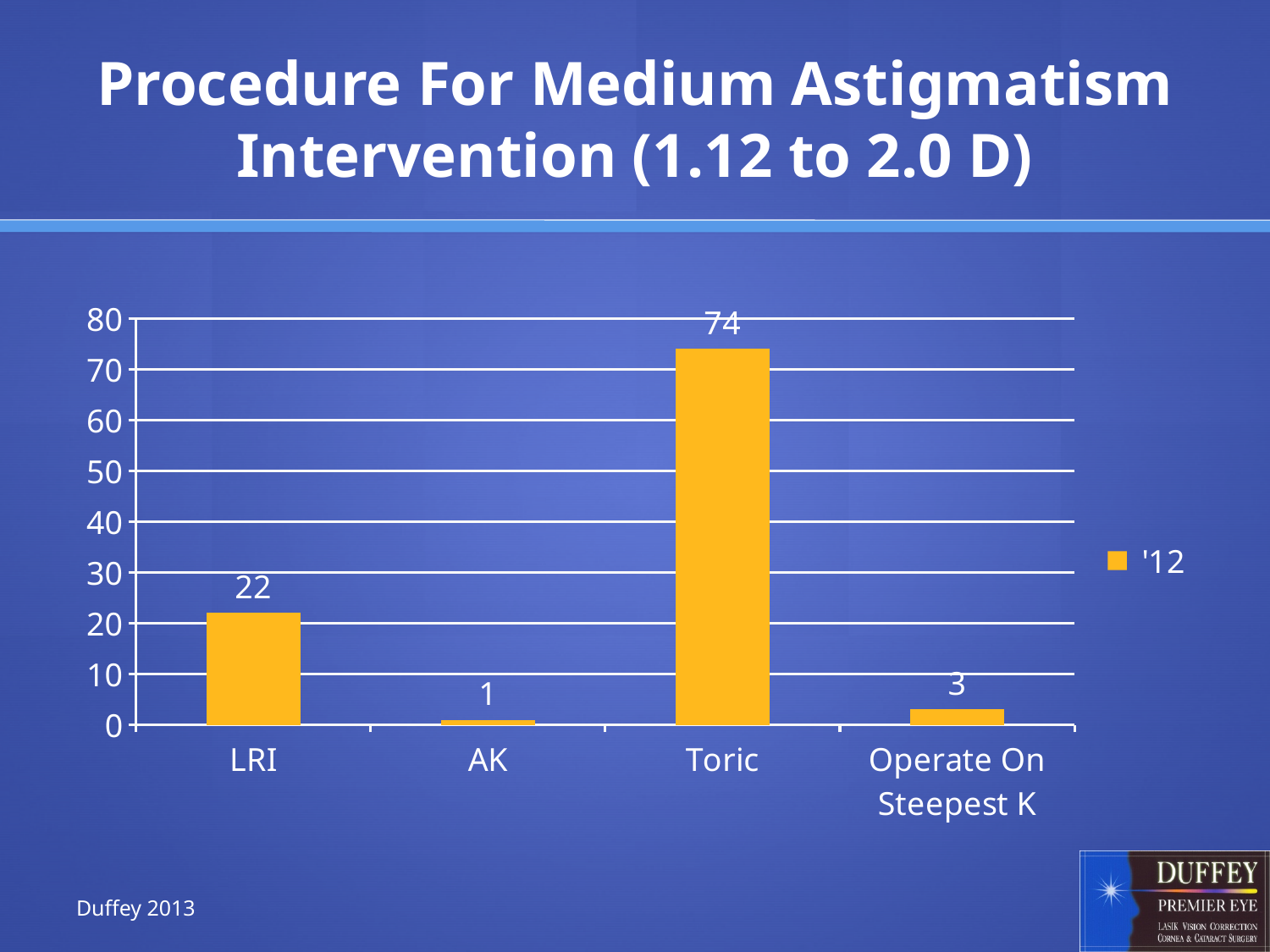
Is the value for Toric greater or less than 70? greater What is the value for LRI? 22 What kind of chart is shown on the slide? bar chart How many series does the legend list? 1 Which is larger, the value for LRI or the value for Operate On Steepest K? LRI What is the value for AK? 1 What is the value for Toric? 74 How many categories are shown on the x axis? 4 What is the value for Operate On Steepest K? 3 Which category has the lowest value? AK Which category has the highest value? Toric What is the difference between the values for Toric and LRI? 52